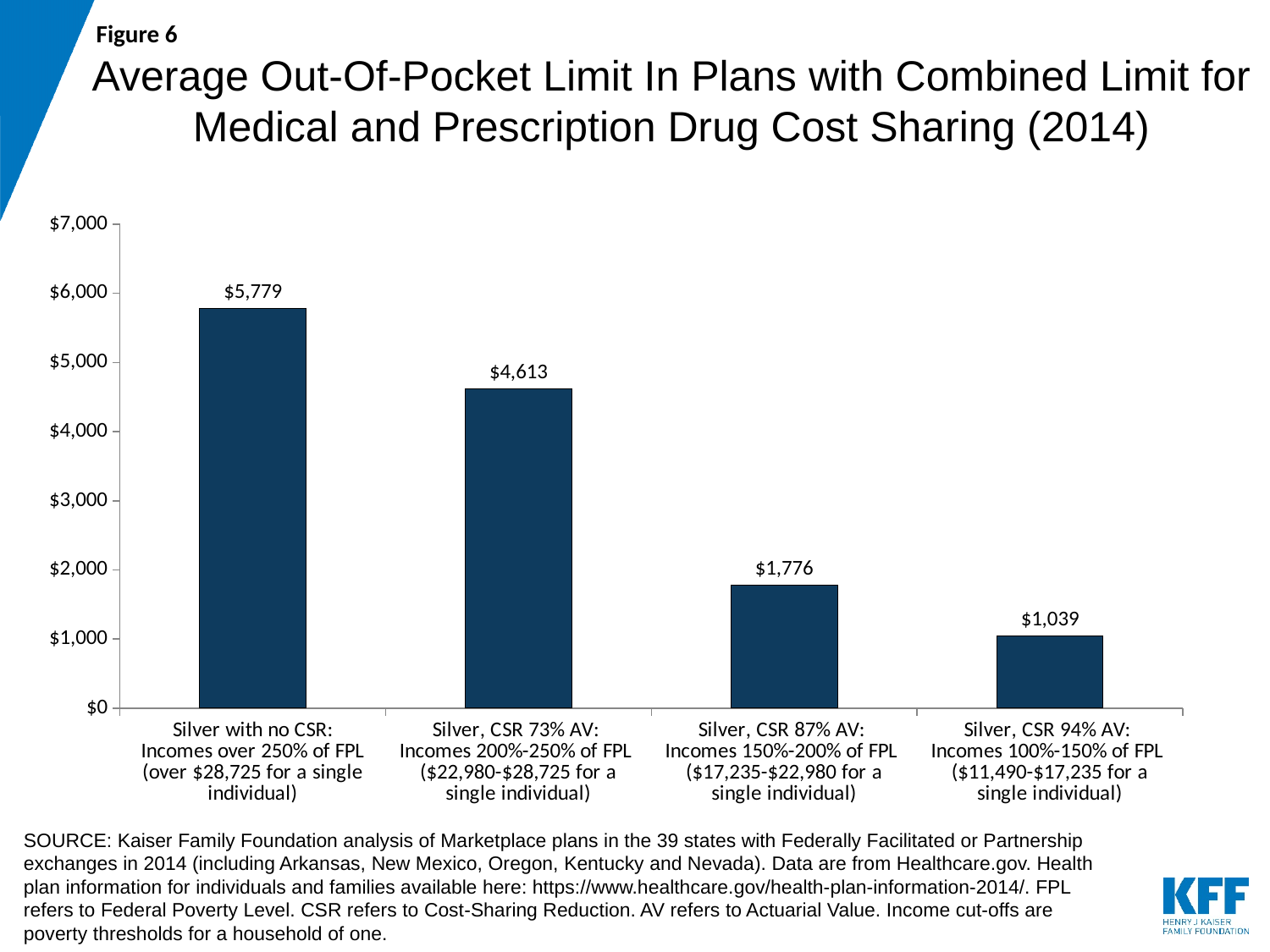
What is the average out-of-pocket limit for Silver, CSR 73% AV plans? $4,613 Which plan category has the highest average out-of-pocket limit? Silver with no CSR Which plan category has the lowest average out-of-pocket limit? Silver, CSR 94% AV What is the difference between the average out-of-pocket limit for Silver with no CSR and Silver, CSR 73% AV? $1,166 What is the average out-of-pocket limit for Silver, CSR 87% AV plans? $1,776 What kind of chart is shown on the slide? Bar chart What is the difference between the average out-of-pocket limit for Silver, CSR 87% AV and Silver, CSR 94% AV? $737 Do the average out-of-pocket limits rise or fall moving from left to right across the categories? Fall What is the average out-of-pocket limit for Silver plans with no CSR? $5,779 How many plan categories are shown in the chart? 4 What is the average out-of-pocket limit for Silver, CSR 94% AV plans? $1,039 Which has a larger average out-of-pocket limit: Silver, CSR 73% AV or Silver, CSR 87% AV? Silver, CSR 73% AV